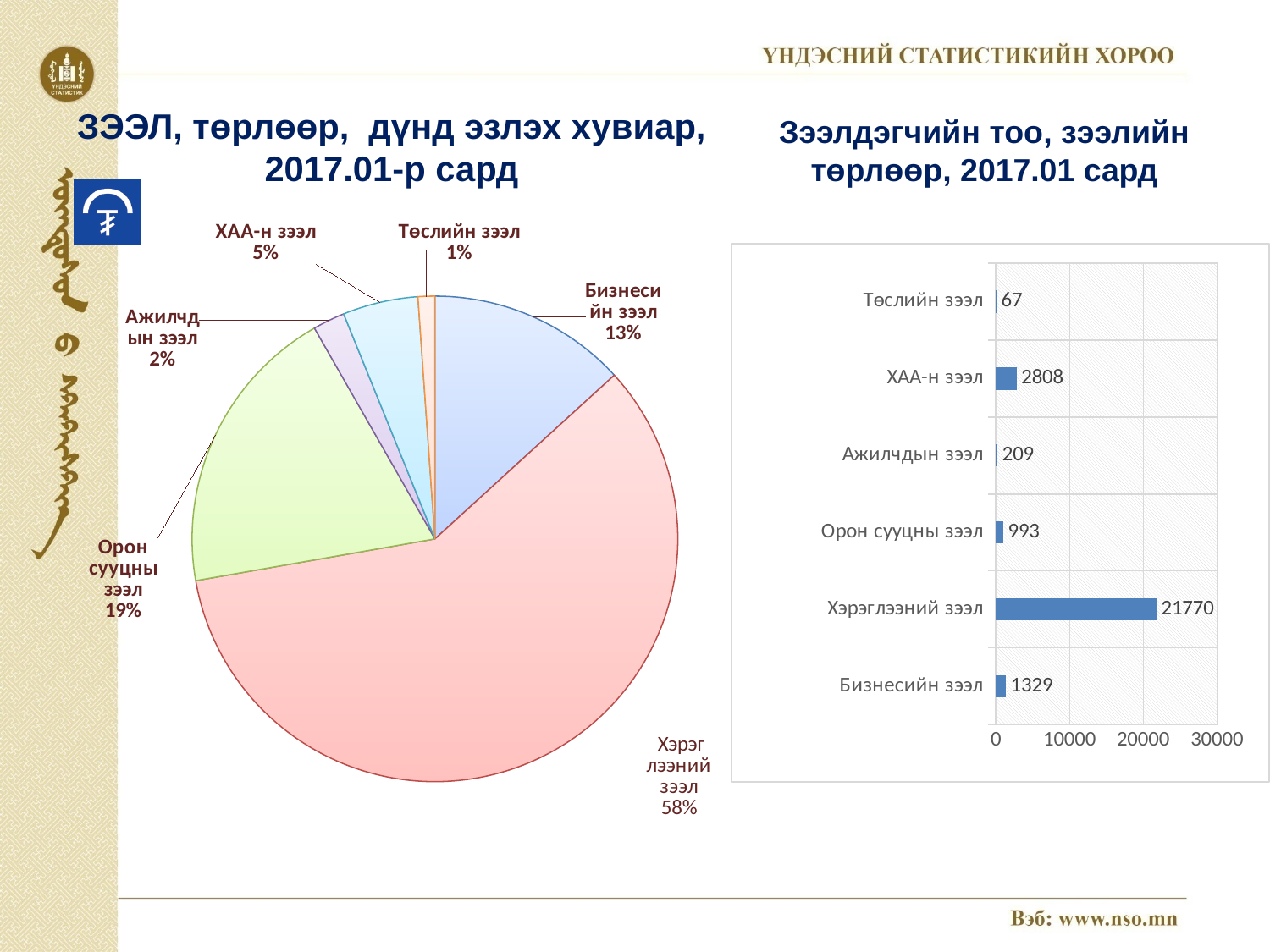
In the pie chart on the left, what share does Орон сууцны зээл have? 19% In the pie chart on the left, which is larger: the share of Бизнесийн зээл or the share of ХАА-н зээл? Бизнесийн зээл In the pie chart on the left, what share does Хэрэглээний зээл have? 58% What kind of chart is the chart on the right? bar chart What is the title of the chart on the right? Зээлдэгчийн тоо, зээлийн төрлөөр, 2017.01 сард In the bar chart on the right, what is the difference between Бизнесийн зээл and Орон сууцны зээл? 336 In the bar chart on the right, is the value for Хэрэглээний зээл greater or less than 20000? greater In the bar chart on the right, which loan type has the lowest value? Төслийн зээл In the bar chart on the right, what is the value for Хэрэглээний зээл? 21770 In the bar chart on the right, what is the value for ХАА-н зээл? 2808 In the pie chart on the left, which loan type has the smallest share? Төслийн зээл In the pie chart on the left, how many slices are there? 6